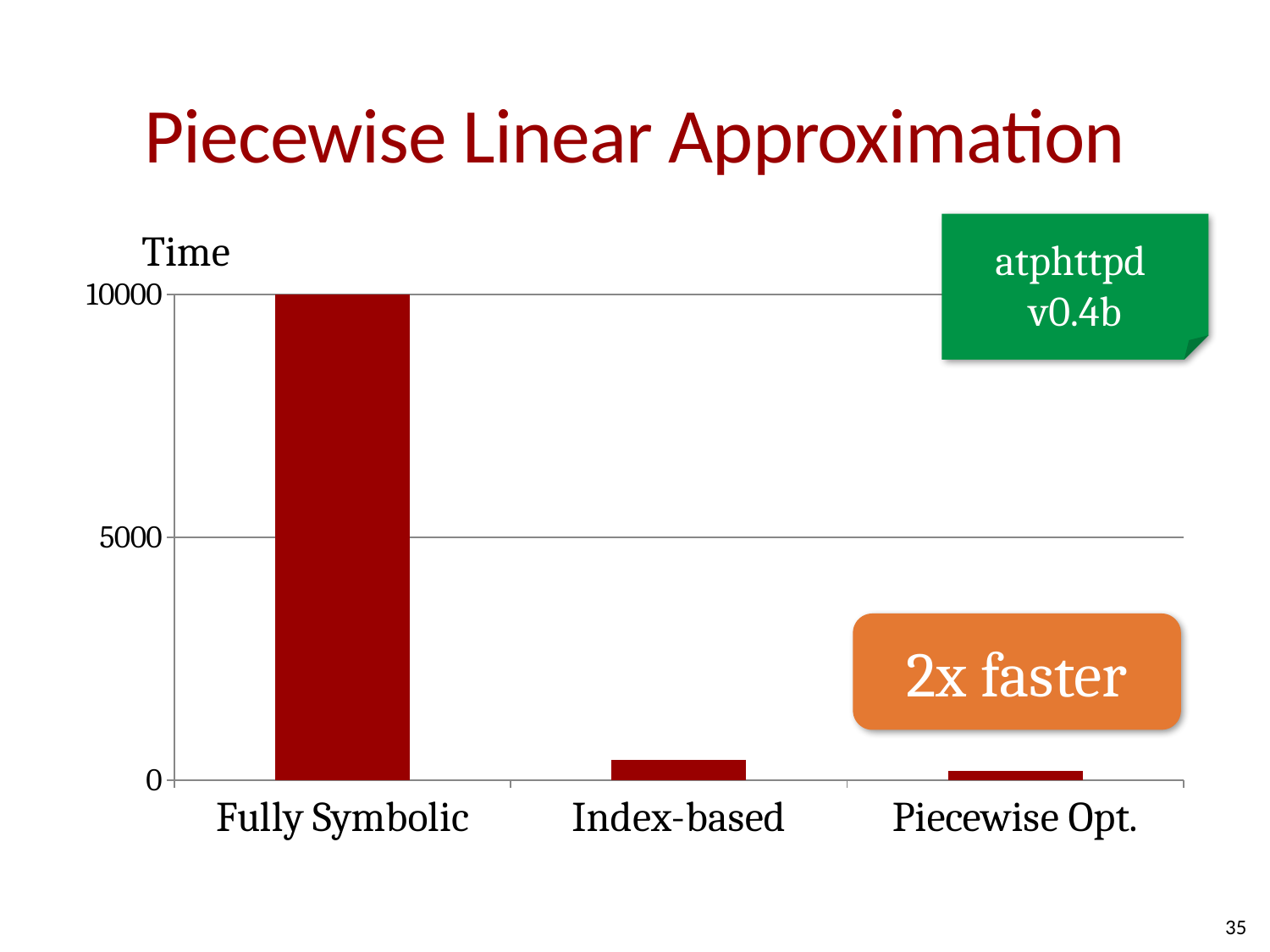
Which is larger, the value for Fully Symbolic or the value for Index-based? Fully Symbolic Which is larger, the value for Index-based or the value for Piecewise Opt.? Index-based What is the label on the vertical axis of the chart? Time Do the values rise or fall from left to right along the x axis? fall Is the value for Piecewise Opt. greater or less than 5000? less Which category has the lowest value in the chart? Piecewise Opt. How many categories are shown on the x axis of the chart? 3 Is the value for Index-based greater or less than 5000? less What kind of chart is shown on the slide? bar chart Which category has the highest value in the chart? Fully Symbolic What does the orange callout on the chart say? 2x faster